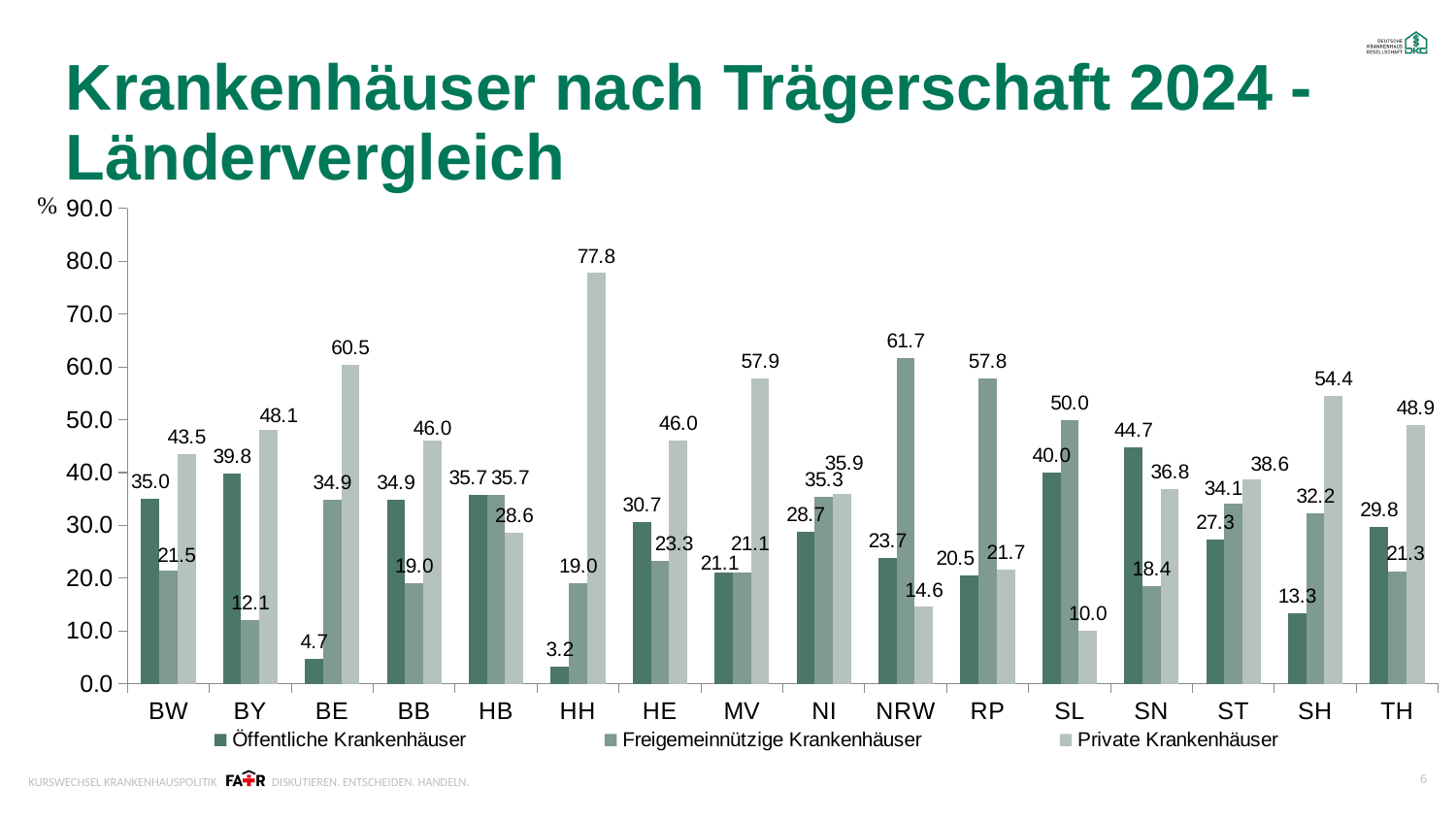
Which state has the lowest value for Öffentliche Krankenhäuser? HH How many series does the legend list? 3 What is the title of the chart on the slide? Krankenhäuser nach Trägerschaft 2024 - Ländervergleich What is the value for Private Krankenhäuser in HH? 77.8 What is the value for Öffentliche Krankenhäuser in SN? 44.7 What is the difference between Freigemeinnützige Krankenhäuser and Öffentliche Krankenhäuser in NRW? 38.0 In BY, which is larger: Öffentliche Krankenhäuser or Private Krankenhäuser? Private Krankenhäuser Which state has the highest value for Freigemeinnützige Krankenhäuser? NRW What kind of chart is shown on the slide? Bar chart How many states (categories) are shown on the x axis? 16 What is the total of the three values shown for SL? 100.0 Which state has the highest value for Private Krankenhäuser? HH